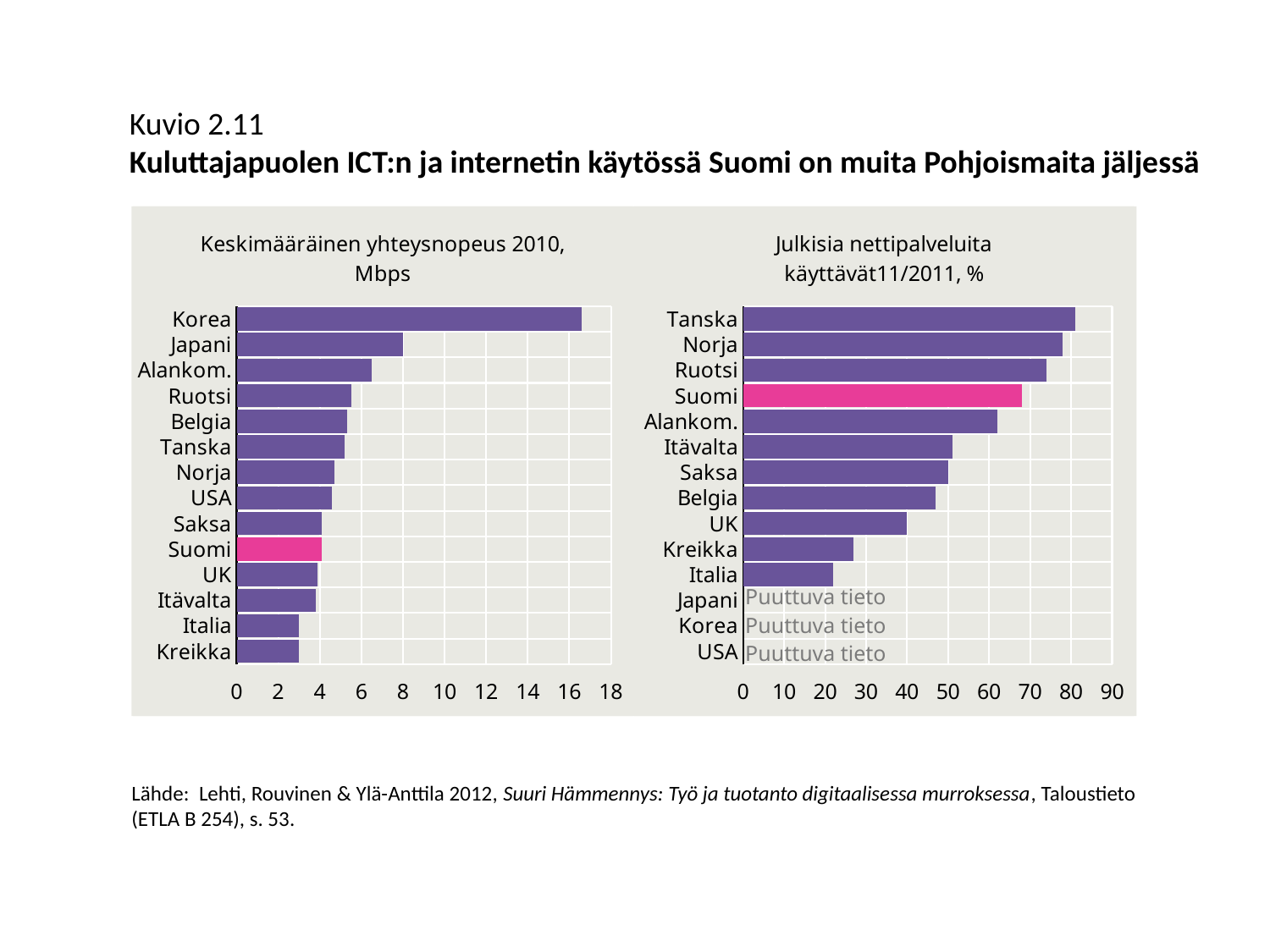
In the right chart 'Julkisia nettipalveluita käyttävät 11/2011, %', is the value for Italia greater or less than 30? less In the right chart 'Julkisia nettipalveluita käyttävät 11/2011, %', which country has the highest value? Tanska In the left chart 'Keskimääräinen yhteysnopeus 2010, Mbps', which country has the highest value? Korea In the right chart 'Julkisia nettipalveluita käyttävät 11/2011, %', which country with a plotted bar has the lowest value? Italia In the left chart 'Keskimääräinen yhteysnopeus 2010, Mbps', which is larger, the value for Japani or the value for Ruotsi? Japani In the right chart 'Julkisia nettipalveluita käyttävät 11/2011, %', is the value for Suomi greater or less than 60? greater In the left chart 'Keskimääräinen yhteysnopeus 2010, Mbps', is the value for Suomi greater or less than 6? less How many countries are listed in the left chart 'Keskimääräinen yhteysnopeus 2010, Mbps'? 14 In the right chart 'Julkisia nettipalveluita käyttävät 11/2011, %', how many countries are marked 'Puuttuva tieto' (missing data)? 3 What kind of chart is the left chart, 'Keskimääräinen yhteysnopeus 2010, Mbps'? Bar chart In the right chart 'Julkisia nettipalveluita käyttävät 11/2011, %', which is larger, the value for Suomi or the value for Alankom.? Suomi